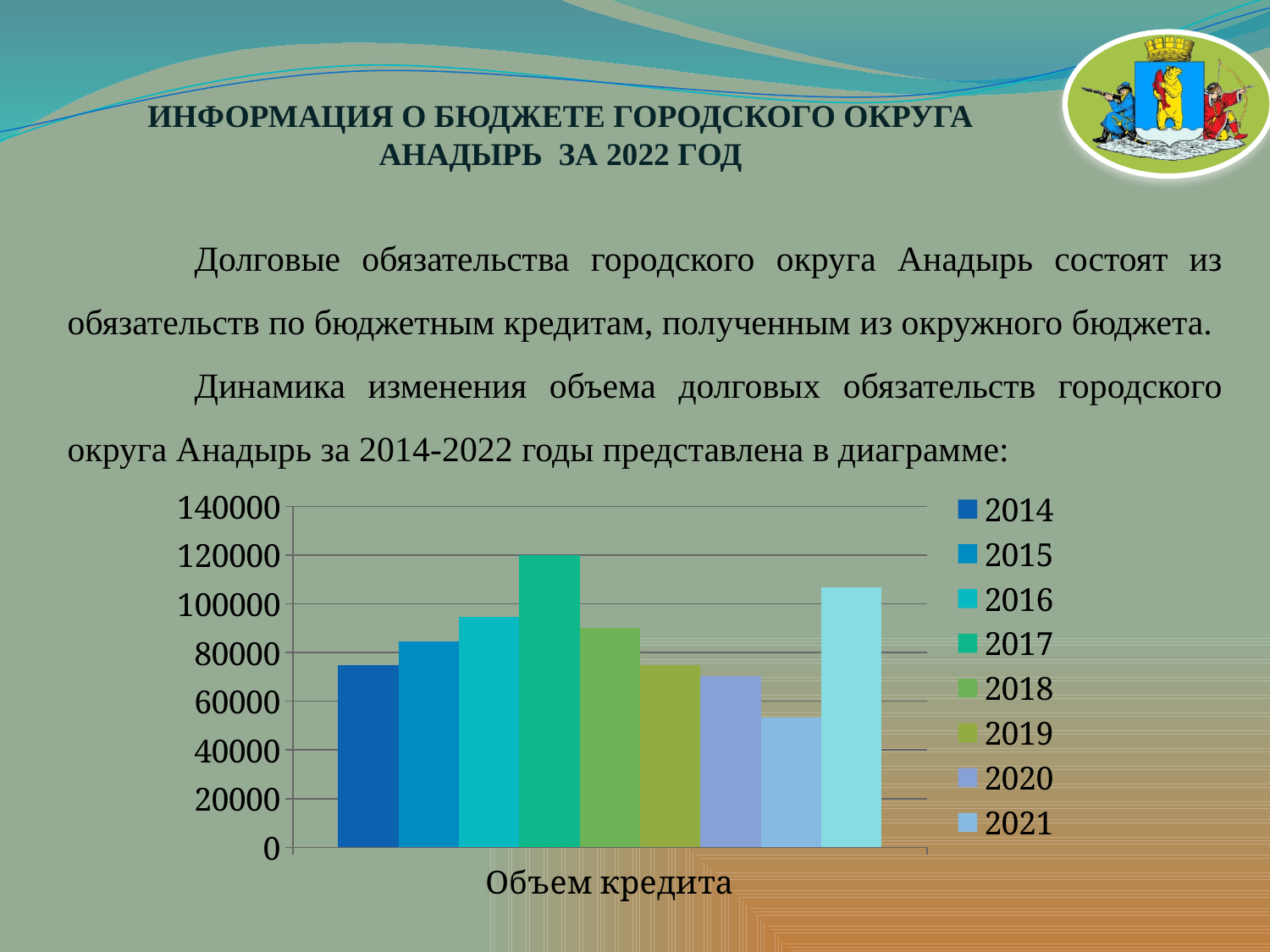
How many bars are plotted in the chart? 9 What is the value of the 2017 bar? 120000 What is the category label shown on the x axis of the chart? Объем кредита Which year has the lowest bar in the chart? 2021 Which is larger, the value for 2018 or the value for 2020? 2018 Is the value for 2018 greater or less than 80000? greater Which is larger, the value for 2016 or the value for 2015? 2016 Which year has the highest bar in the chart? 2017 Is the value for 2021 greater or less than 60000? less Is the value for 2020 greater or less than 80000? less What kind of chart is shown on the slide? bar chart